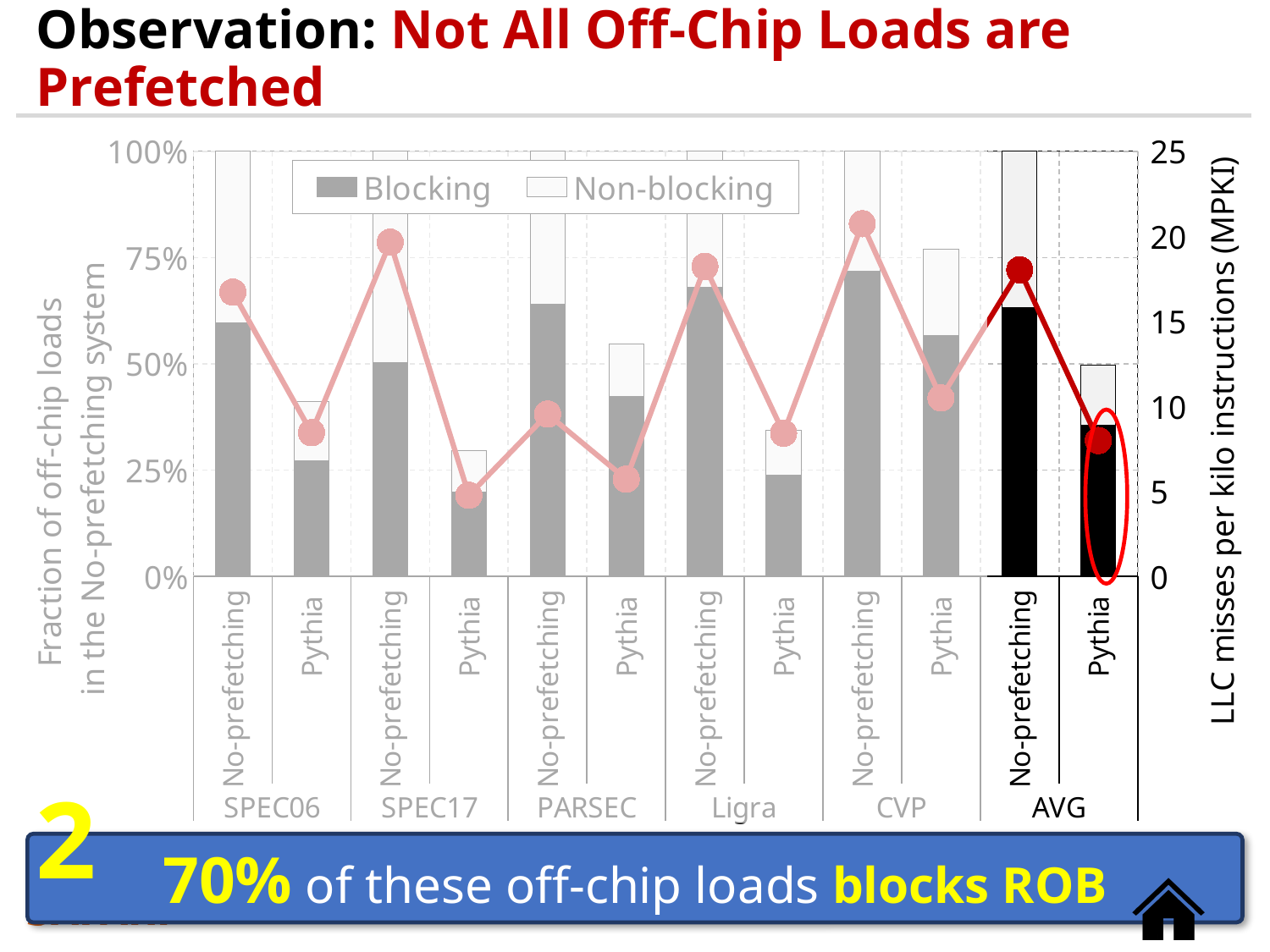
Is the Blocking value for Pythia in SPEC17 greater or less than 25%? less Is the Blocking value for Pythia in AVG greater or less than 50%? less Is the LLC MPKI value for No-prefetching in AVG greater or less than 15? greater How many series does the legend list? 2 How many benchmark groups are shown along the x axis? 6 What kind of chart is shown on the slide? Stacked bar chart with a line overlay How many bars are plotted in total? 12 Which bar has the lowest Blocking fraction? Pythia in SPEC17 What are the two series named in the legend? Blocking and Non-blocking What is the total height of the No-prefetching stacked bar for SPEC06? 100%